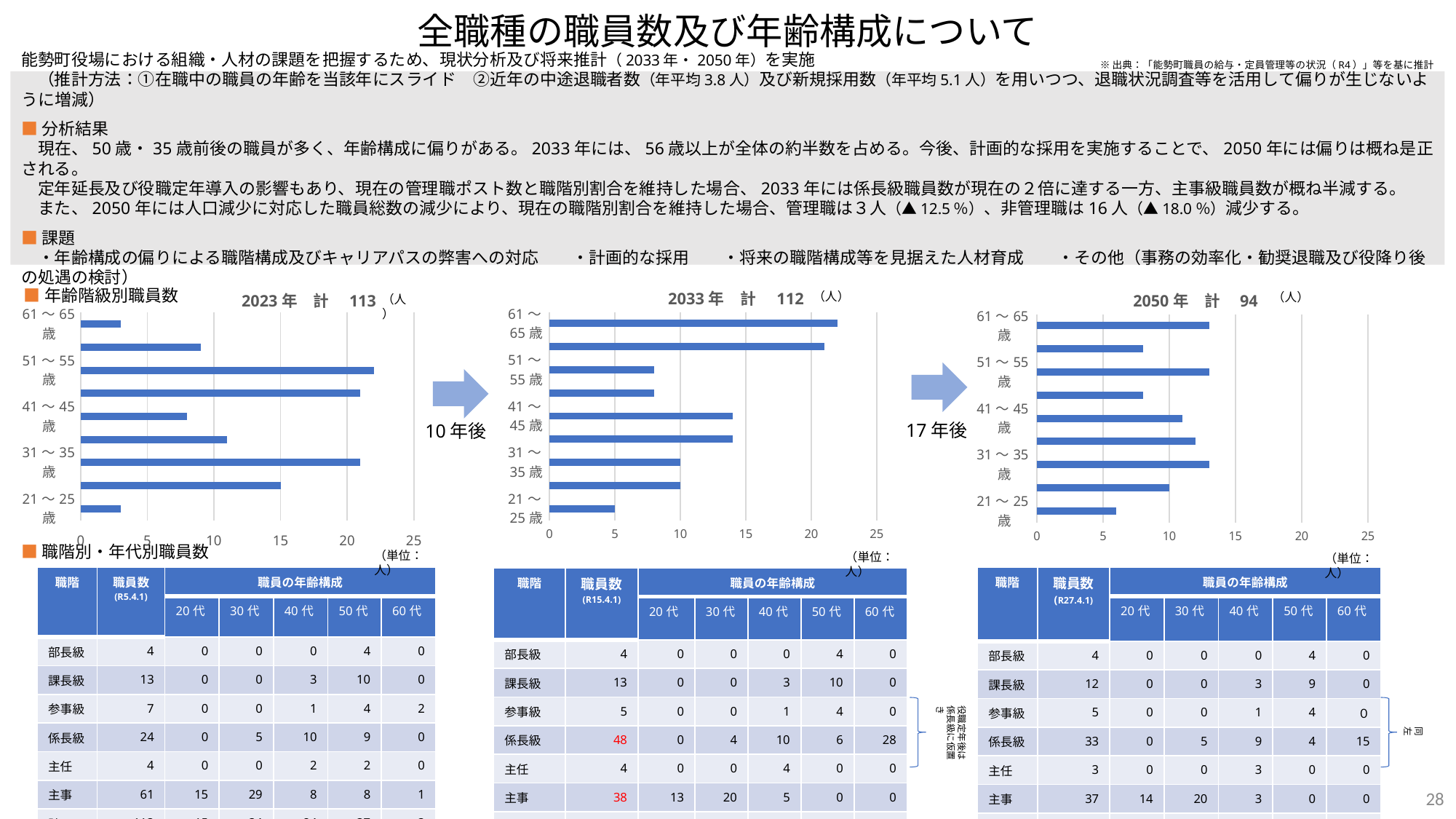
In the 2033年 計 112 chart, what is the value for 21～25歳? 5 In the 2033年 計 112 chart, which is larger, the value for 61～65歳 or the value for 21～25歳? 61～65歳 What total (計) is shown in the title of the rightmost bar chart? 94 In the 2033年 計 112 chart, which age group has the lowest value? 21～25歳 In the 2050年 計 94 chart, is the value for 21～25歳 greater or less than 10? less In the 2023年 計 113 chart, how many bars are plotted? 9 In the 2023年 計 113 chart, is the value for 61～65歳 greater or less than 5? less In the 2050年 計 94 chart, is the value for 61～65歳 greater or less than 10? greater What kind of chart is the 2023年 計 113 chart? bar chart In the 2023年 計 113 chart, which is larger, the value for 51～55歳 or the value for 61～65歳? 51～55歳